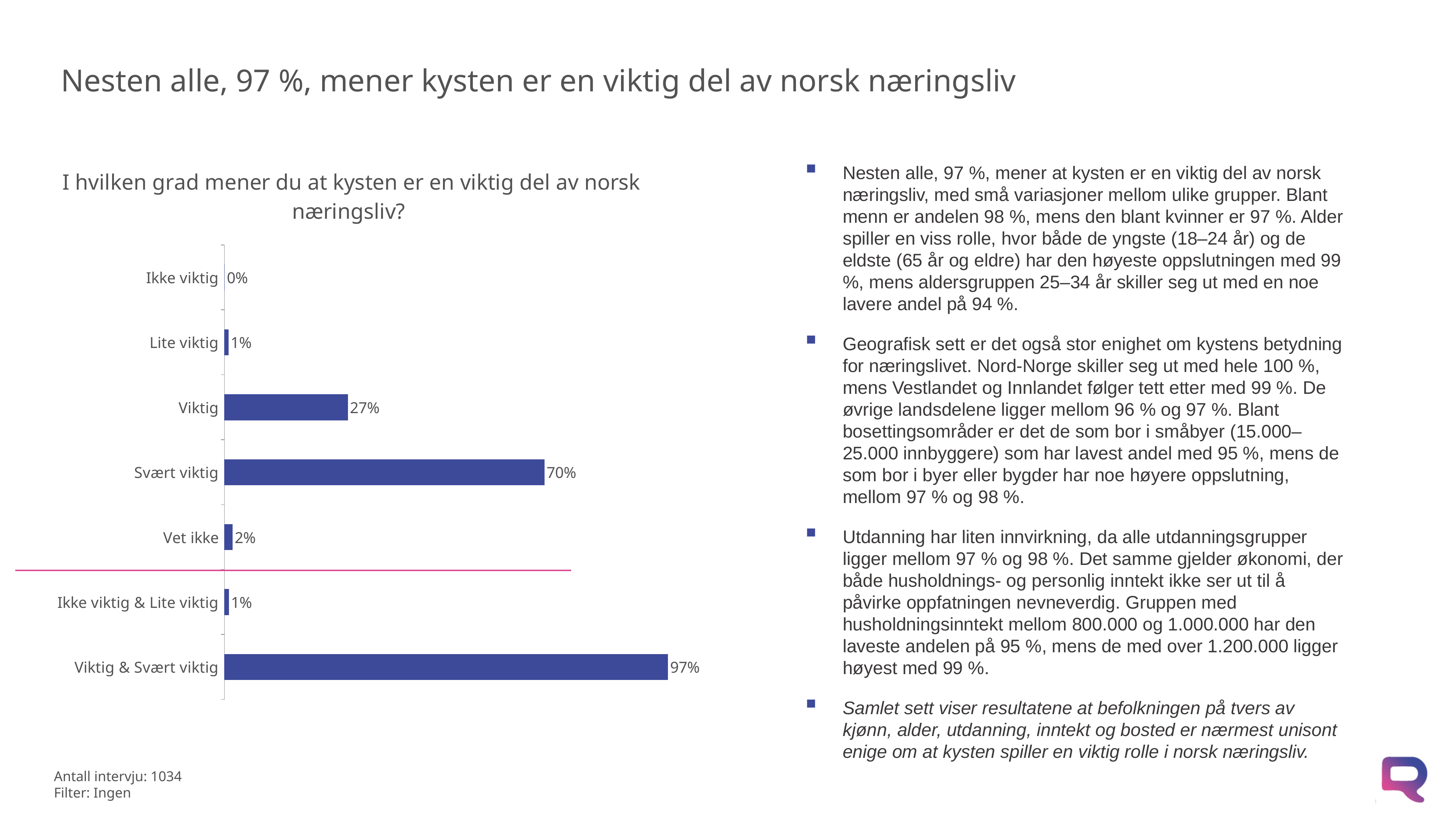
What is the title of the chart? I hvilken grad mener du at kysten er en viktig del av norsk næringsliv? Which category has the lowest value? Ikke viktig What is the value for "Svært viktig"? 70% How many categories are shown in the chart? 7 What is the difference between "Svært viktig" and "Viktig"? 43% Which is larger, "Vet ikke" or "Lite viktig"? Vet ikke What is the value for "Vet ikke"? 2% What is the value for "Viktig & Svært viktig"? 97% What is the value for "Viktig"? 27% What kind of chart is shown on the slide? Bar chart What is the value for "Ikke viktig"? 0% Which category has the highest value? Viktig & Svært viktig